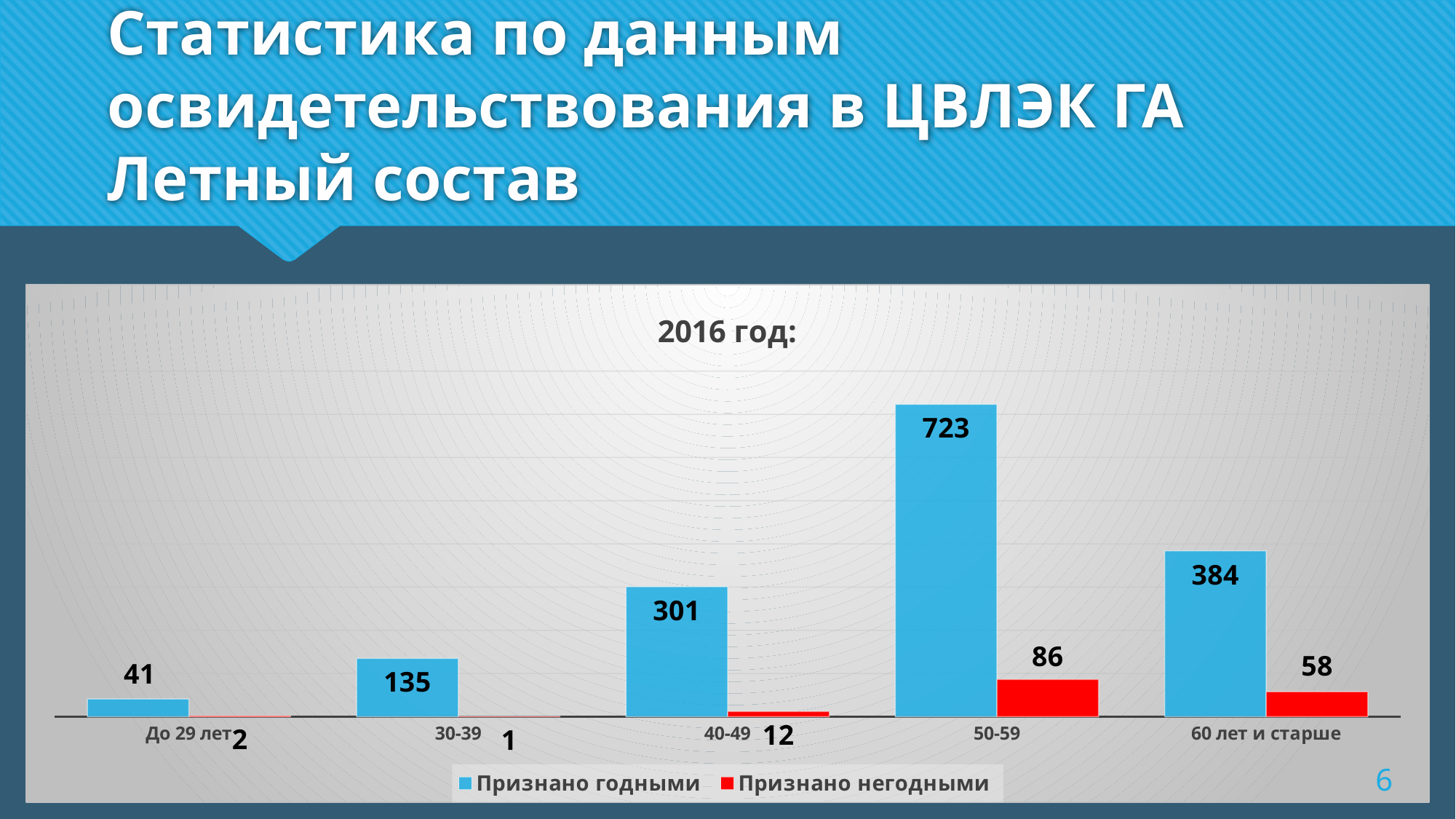
What is the title of the chart? 2016 год: Which age group has the highest 'Признано годными' value? 50-59 How many series does the legend list? 2 What kind of chart is shown on the slide? Bar chart What is the value of 'Признано годными' for the 'До 29 лет' group? 41 Which age group has the lowest 'Признано негодными' value? 30-39 What is the value of 'Признано негодными' for the 40-49 age group? 12 What is the difference between 'Признано годными' and 'Признано негодными' for the '60 лет и старше' group? 326 How many age groups are shown on the x axis? 5 What is the value of 'Признано годными' for the 50-59 age group? 723 Which is larger: 'Признано годными' for 30-39 or for 40-49? 40-49 Which colour represents 'Признано негодными' in the chart? Red